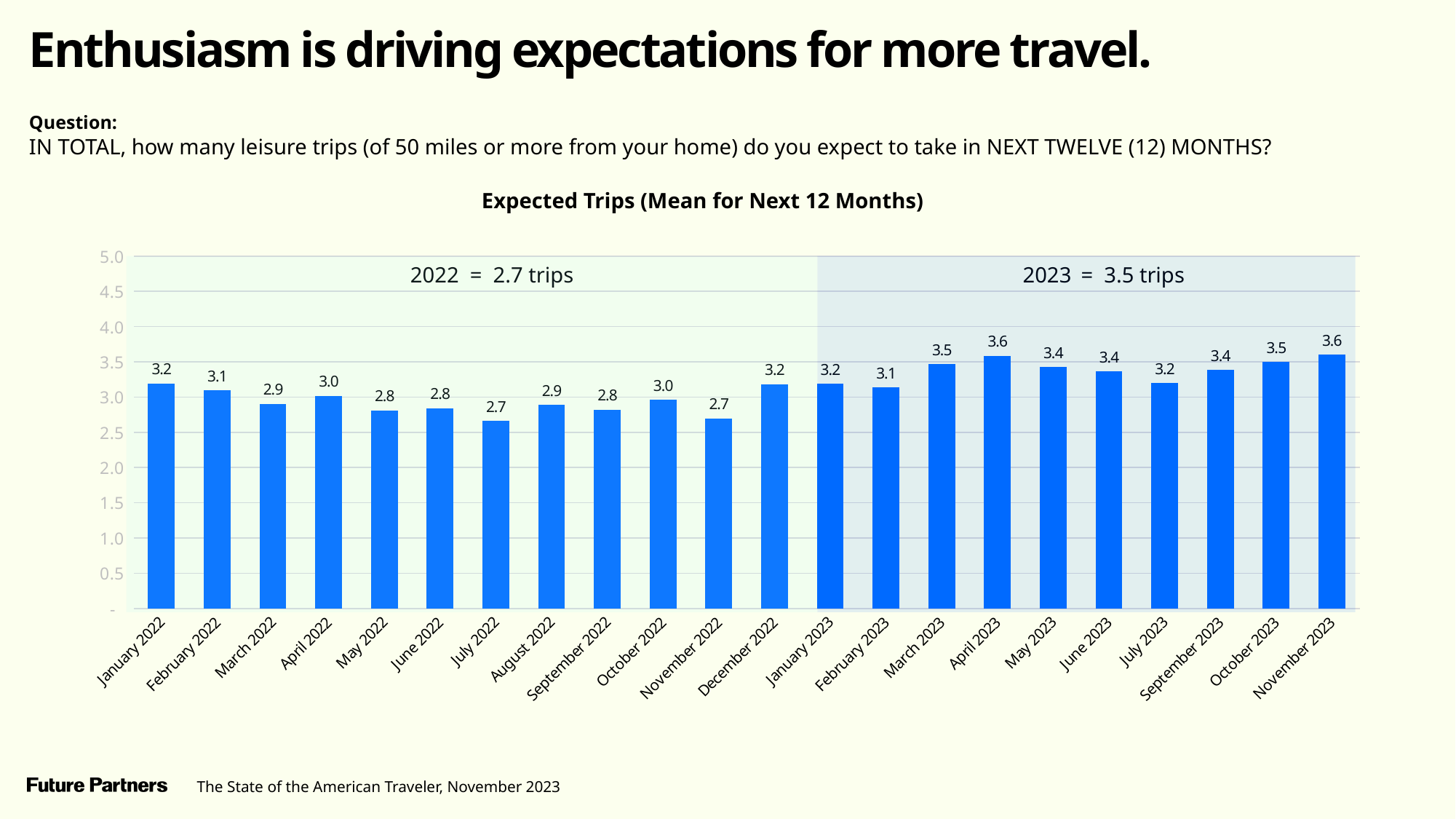
Do the values rise or fall from January 2023 to April 2023? Rise How many bars are plotted on the chart? 22 What is the lowest value plotted on the chart? 2.7 What is the value shown for December 2022? 3.2 What is the highest value plotted on the chart? 3.6 What is the expected number of trips for April 2023? 3.6 According to the annotation on the chart, what was the average number of expected trips for 2023? 3.5 trips What kind of chart is shown on the slide? Bar chart What is the value shown for September 2023? 3.4 What is the difference between the values for November 2023 and July 2022? 0.9 Which is larger, the value for March 2023 or the value for March 2022? March 2023 What is the expected number of trips for July 2022? 2.7